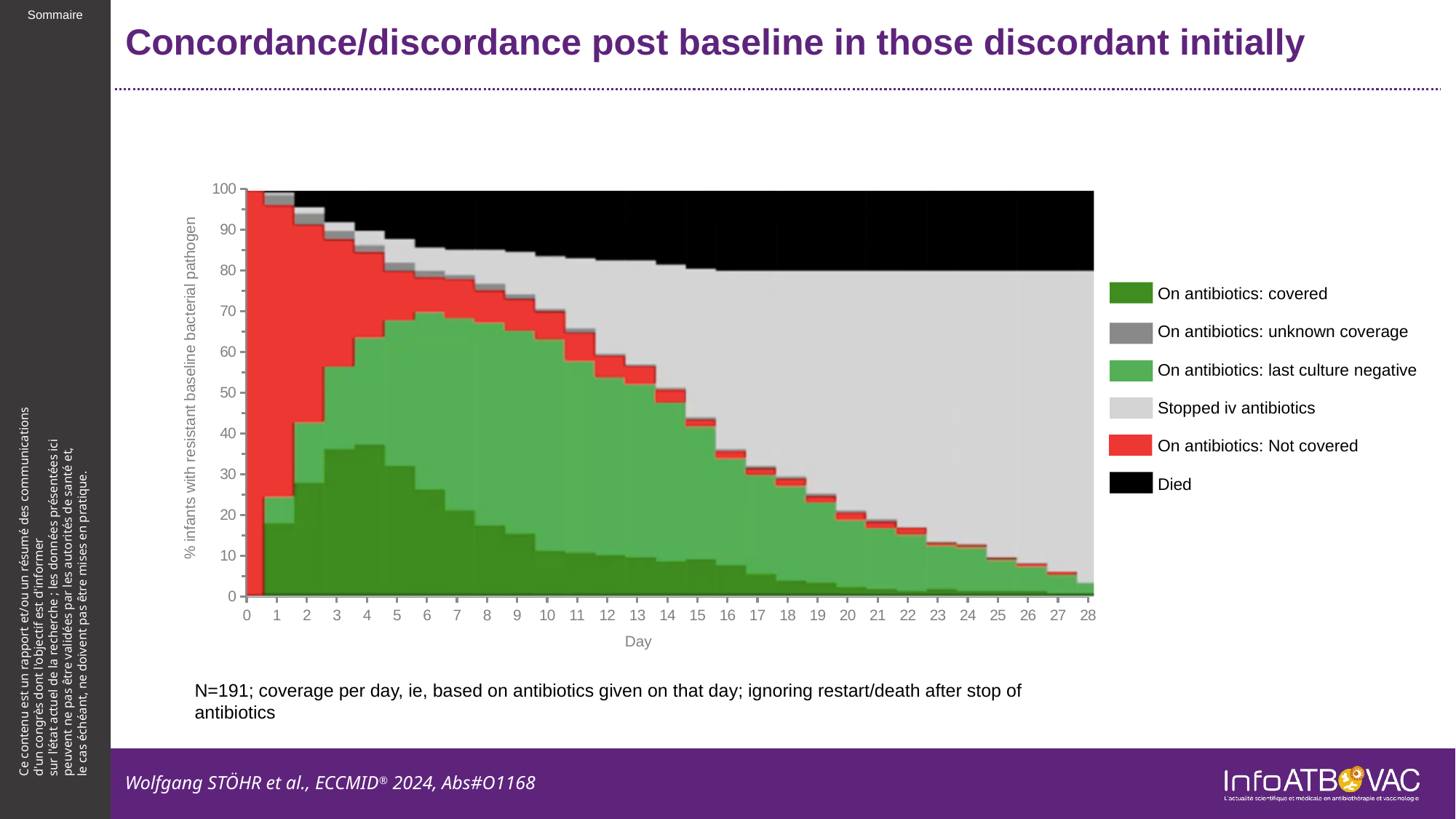
What is the label of the y axis? % infants with resistant baseline bacterial pathogen How many days are shown along the x axis, from day 0 to day 28? 29 What kind of chart is shown on the slide? Stacked area chart Does the 'On antibiotics: Not covered' share rise or fall from day 0 to day 28? Fall Is the value for 'Died' at day 28 greater or less than 10? greater Which category accounts for the largest share of infants at day 28? Stopped iv antibiotics How many series does the legend list? 6 Is the value for 'On antibiotics: covered' at day 4 greater or less than 30? greater What is the title of the chart on the slide? Concordance/discordance post baseline in those discordant initially Is the value for 'On antibiotics: Not covered' at day 0 greater or less than 90? greater At day 10, which is larger: 'On antibiotics: last culture negative' or 'On antibiotics: covered'? On antibiotics: last culture negative Does the 'Stopped iv antibiotics' share rise or fall from day 0 to day 28? Rise